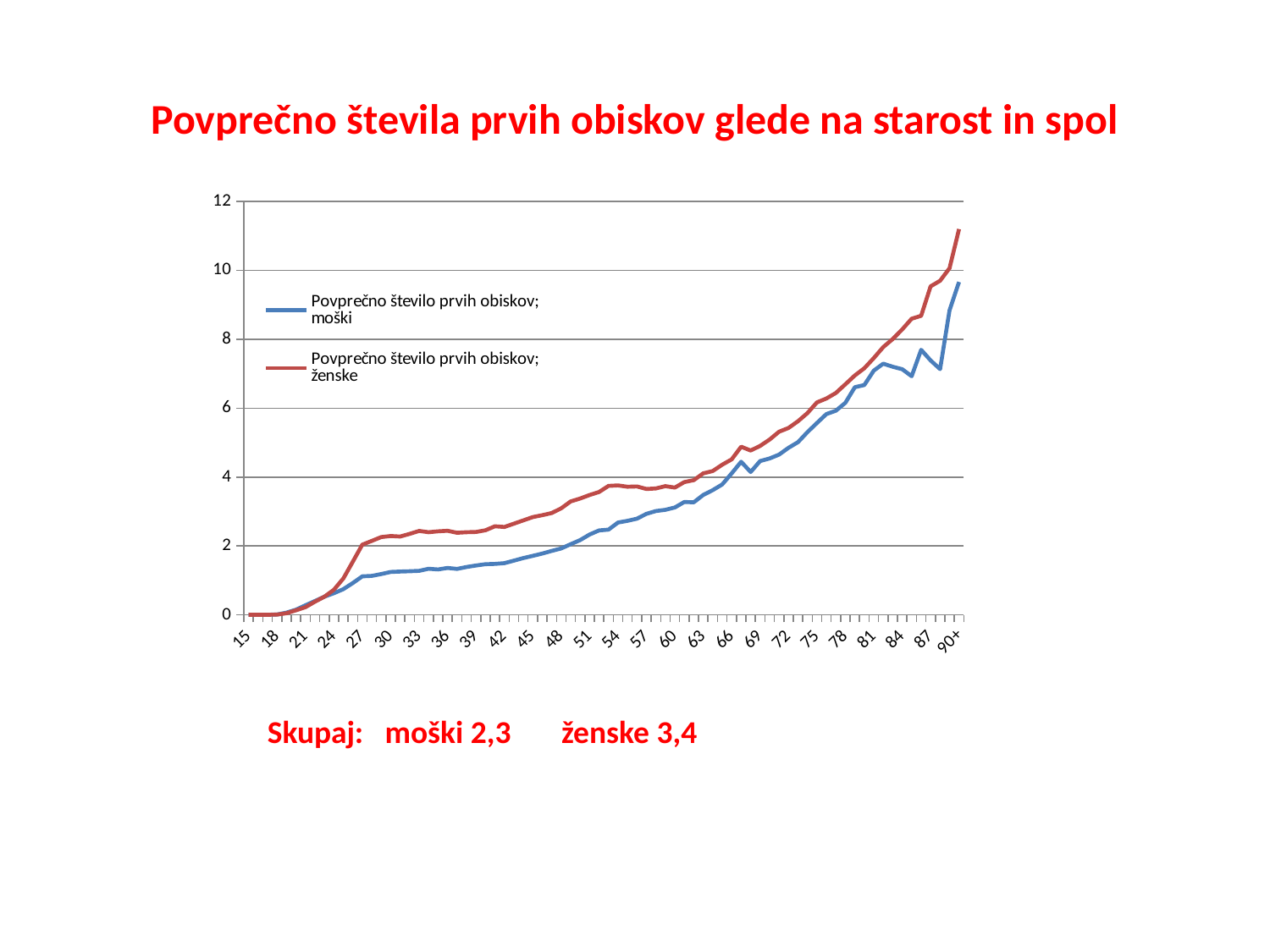
Do the values for 'Povprečno število prvih obiskov; moški' generally rise or fall as age increases along the x axis? rise Is the value for 'Povprečno število prvih obiskov; ženske' at age 90+ greater or less than 10? greater What is the title of the chart on the slide? Povprečno števila prvih obiskov glede na starost in spol Is the value for 'Povprečno število prvih obiskov; moški' at age 30 greater or less than 2? less At age 90+, which series has the larger value: 'Povprečno število prvih obiskov; moški' or 'Povprečno število prvih obiskov; ženske'? Povprečno število prvih obiskov; ženske What kind of chart is shown on the slide? line chart How many series does the legend list? 2 Is the value for 'Povprečno število prvih obiskov; moški' at age 84 greater or less than 6? greater At age 30, which series has the larger value: 'Povprečno število prvih obiskov; moški' or 'Povprečno število prvih obiskov; ženske'? Povprečno število prvih obiskov; ženske Which colour is the line for 'Povprečno število prvih obiskov; ženske'? red